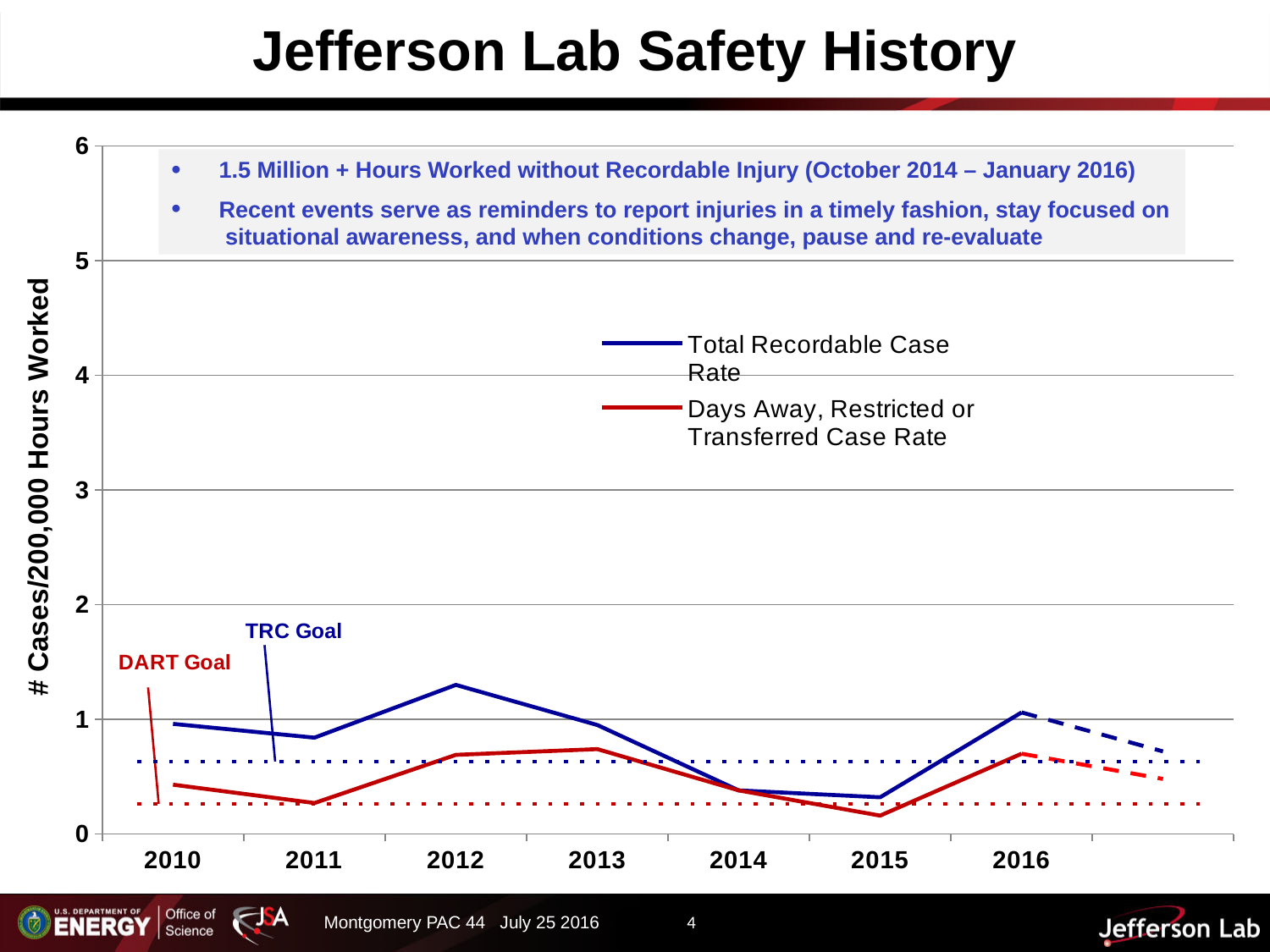
In which year is the Total Recordable Case Rate highest? 2012 What is the title of the y axis of the chart? # Cases/200,000 Hours Worked Does the Total Recordable Case Rate rise or fall from 2015 to 2016? Rise How many years are labeled on the x axis of the chart? 7 In which year is the Days Away, Restricted or Transferred Case Rate lowest? 2015 Is the Total Recordable Case Rate for 2012 greater or less than 1? greater Is the Total Recordable Case Rate for 2014 greater or less than 1? less How many series does the chart legend list? 2 Is the Days Away, Restricted or Transferred Case Rate for 2013 greater or less than 1? less Does the Total Recordable Case Rate rise or fall from 2012 to 2015? Fall What kind of chart is shown on the slide? Line chart In 2012, which is larger: the Total Recordable Case Rate or the Days Away, Restricted or Transferred Case Rate? Total Recordable Case Rate